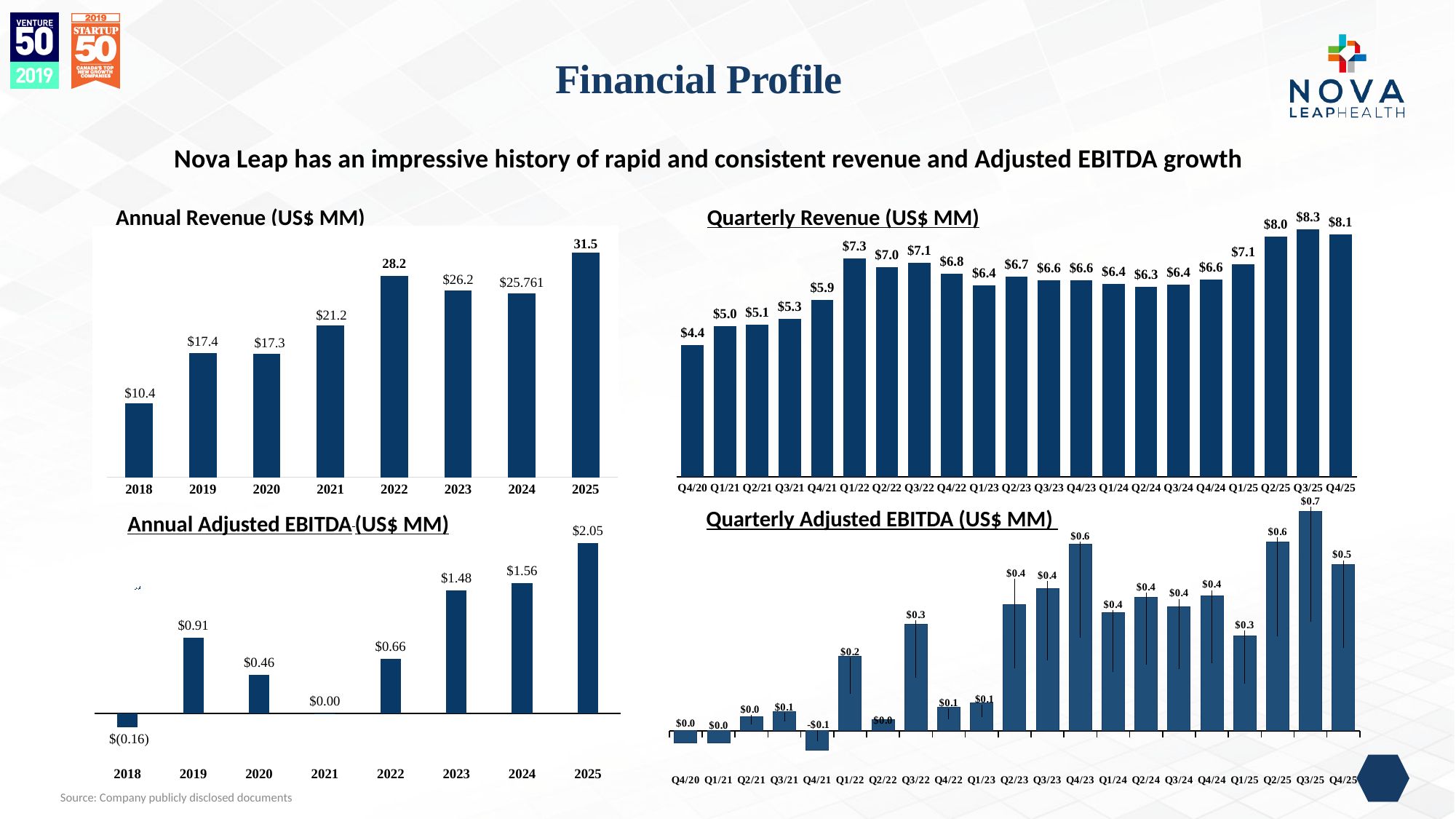
On the Quarterly Revenue (US$ MM) chart, which quarter has the lowest revenue? Q4/20 On the Annual Revenue (US$ MM) chart, what is the value for 2021? $21.2 On the Annual Revenue (US$ MM) chart, which year has the highest revenue? 2025 On the Quarterly Adjusted EBITDA (US$ MM) chart, which quarter has the highest value? Q3/25 On the Quarterly Revenue (US$ MM) chart, what is the value for Q3/25? $8.3 On the Annual Adjusted EBITDA (US$ MM) chart, what is the value for 2018? $(0.16) On the Annual Adjusted EBITDA (US$ MM) chart, what is the difference between the 2025 and 2024 values? $0.49 On the Annual Revenue (US$ MM) chart, what is the difference between the 2022 and 2023 values? 2.0 On the Quarterly Revenue (US$ MM) chart, how many quarters are plotted? 21 On the Annual Revenue (US$ MM) chart, how many years are shown? 8 On the Annual Revenue (US$ MM) chart, which year has the lowest revenue? 2018 On the Quarterly Revenue (US$ MM) chart, which is larger, Q1/22 or Q4/22? Q1/22